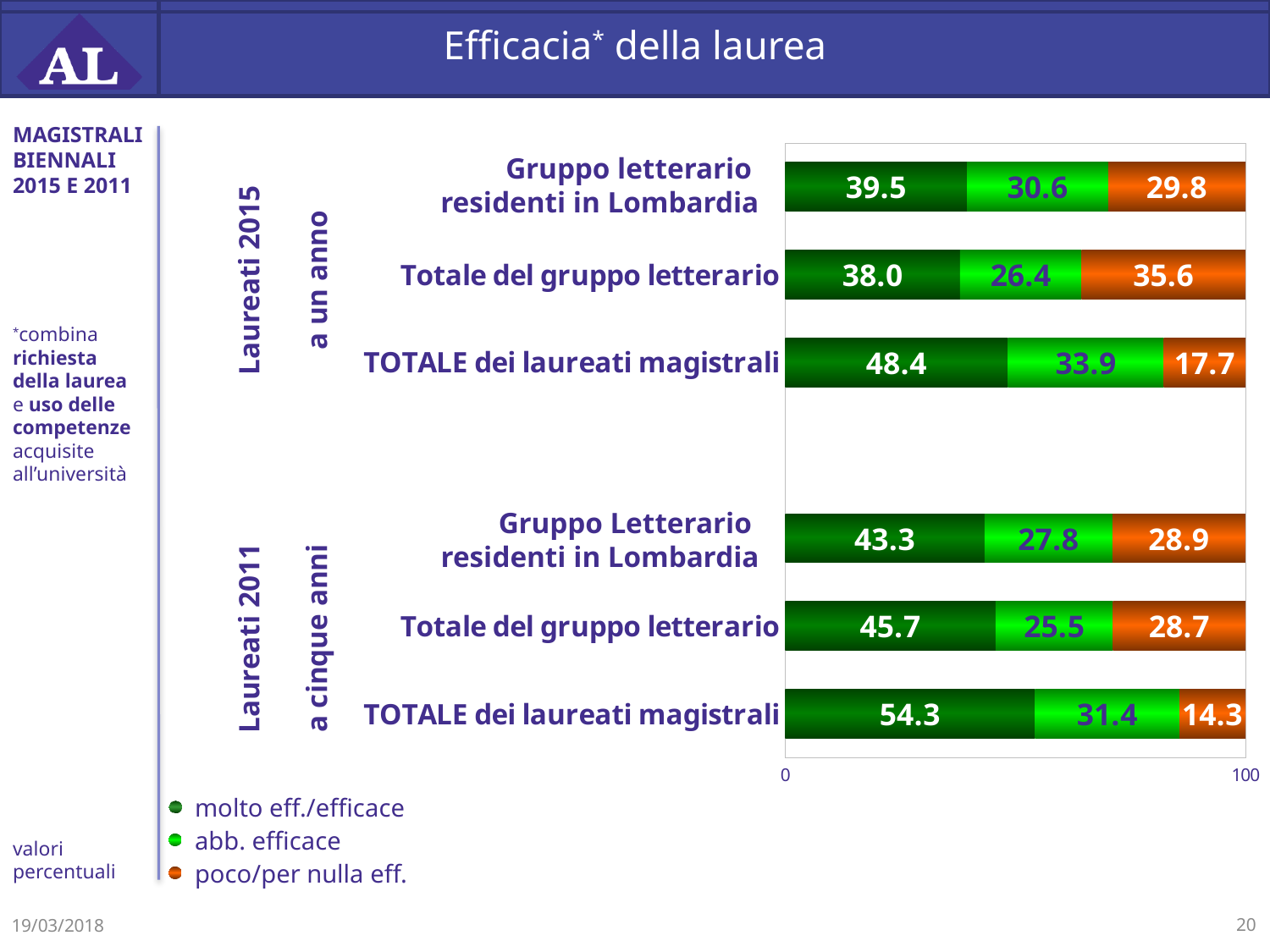
What is the total of the stacked bar for Gruppo letterario residenti in Lombardia in Laureati 2015 (a un anno)? 99.9 Which legend entry is shown in orange? poco/per nulla eff. How many series does the legend list? 3 What type of chart is shown on the slide? stacked bar chart For Laureati 2015 (a un anno), which is larger for Totale del gruppo letterario: the 'abb. efficace' value or the 'poco/per nulla eff.' value? poco/per nulla eff. For Laureati 2015 (a un anno), what is the 'molto eff./efficace' value for TOTALE dei laureati magistrali? 48.4 What is the difference between the 'molto eff./efficace' values for TOTALE dei laureati magistrali in Laureati 2011 (54.3) and Laureati 2015 (48.4)? 5.9 Which category has the highest 'molto eff./efficace' value in the chart? TOTALE dei laureati magistrali (Laureati 2011, a cinque anni) Which category has the lowest 'poco/per nulla eff.' value in the chart? TOTALE dei laureati magistrali (Laureati 2011, a cinque anni) For Laureati 2015 (a un anno), what is the 'abb. efficace' value for Gruppo letterario residenti in Lombardia? 30.6 For Laureati 2011 (a cinque anni), what is the 'poco/per nulla eff.' value for Totale del gruppo letterario? 28.7 How many bars (categories) are plotted in the chart? 6